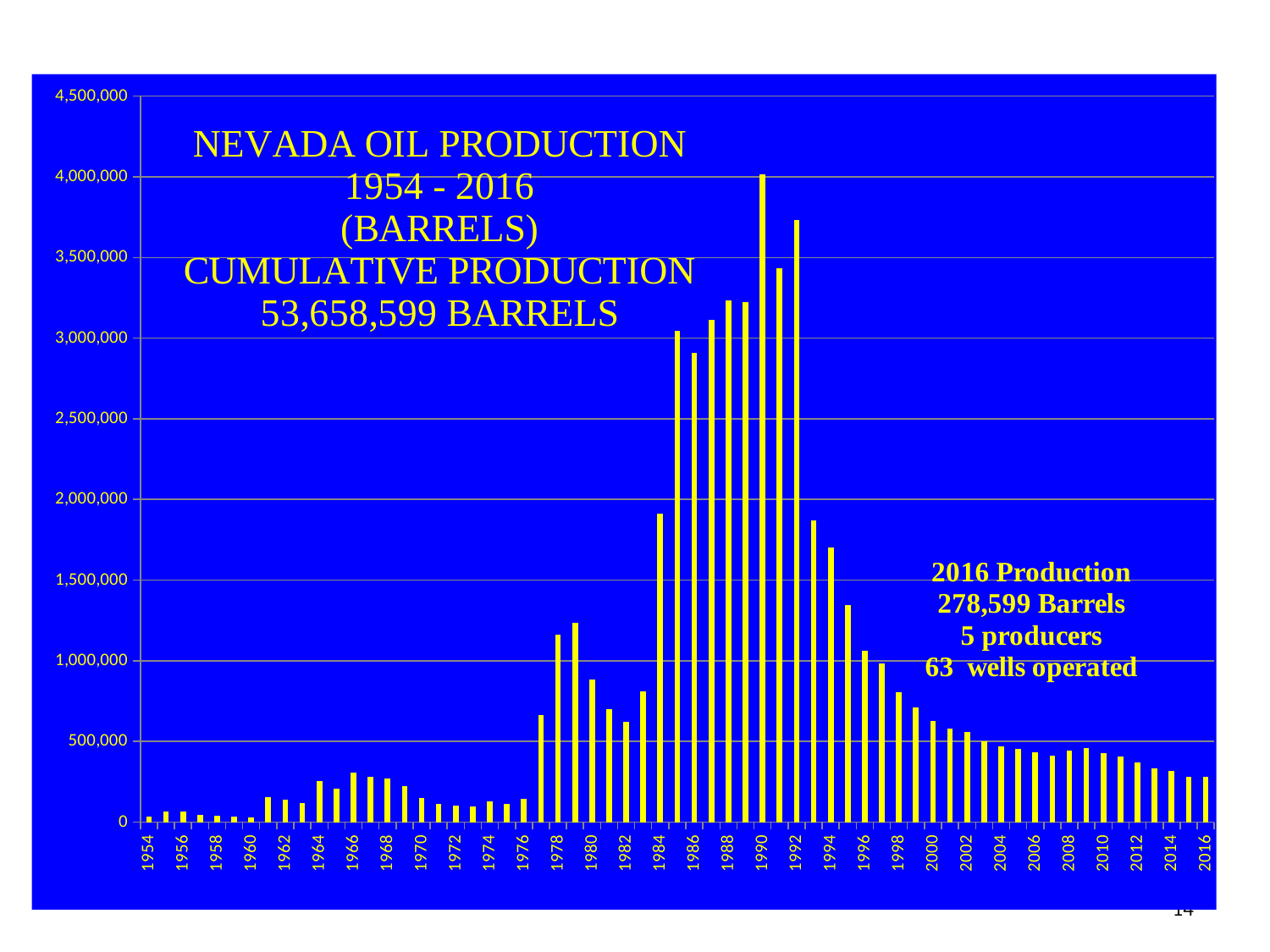
Is the value for 1984 greater or less than 2,000,000? less What was Nevada's oil production in 2016 according to the annotation on the chart? 278,599 Barrels Do the production values generally rise or fall from 1992 to 2016? fall Is the value for 1966 greater or less than 500,000? less What kind of chart is shown on the slide? bar chart Is the value for 1978 greater or less than 1,000,000? greater Which year has the larger production, 1986 or 1988? 1988 What cumulative production figure is stated on the chart? 53,658,599 BARRELS Which year has the larger production, 1990 or 1992? 1990 Which year has the highest oil production in the chart? 1990 What is the title of the chart? NEVADA OIL PRODUCTION 1954 - 2016 (BARRELS)